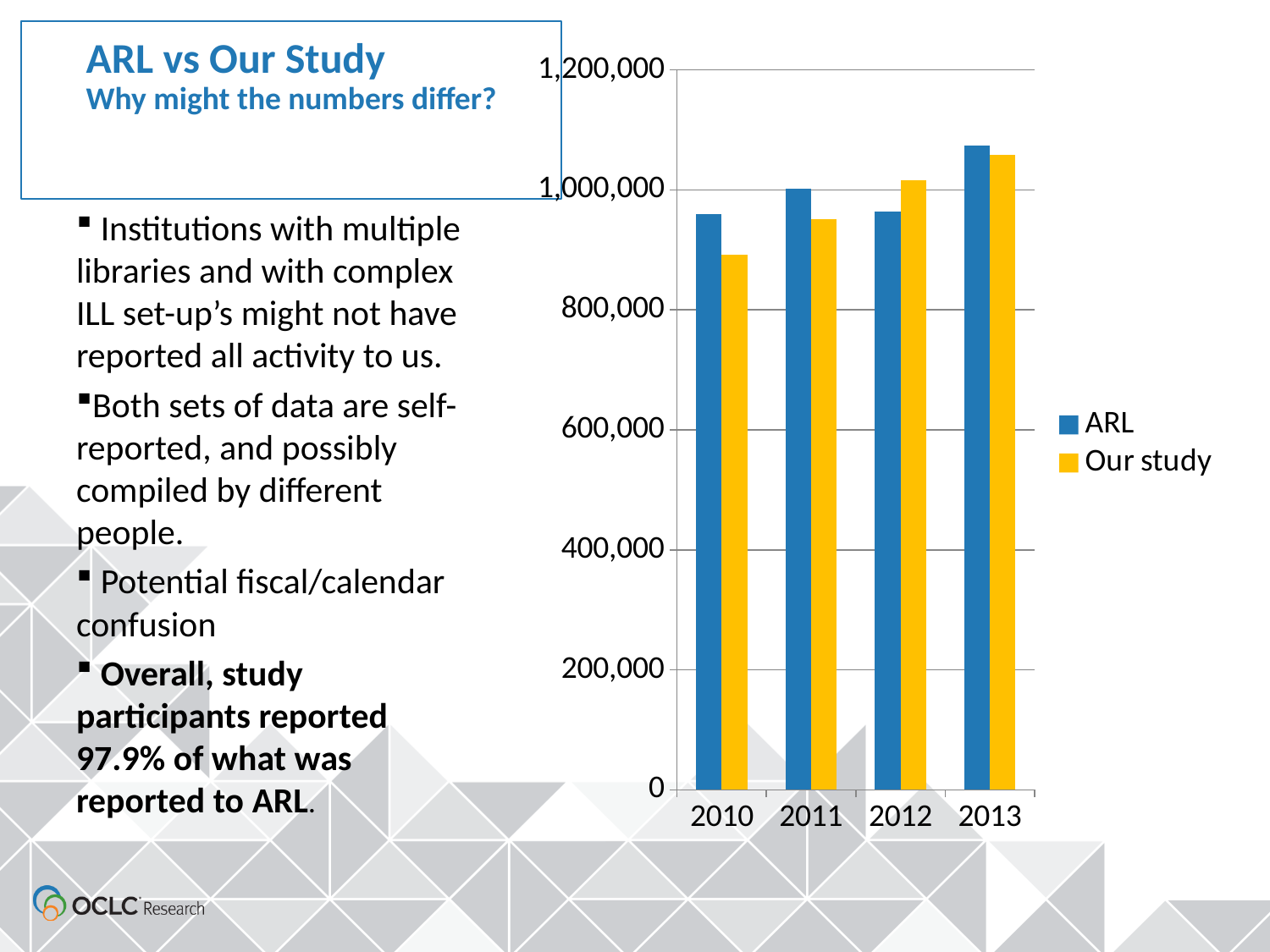
Which year has the lowest Our study value? 2010 Is the Our study value for 2010 greater or less than 1,000,000? less Which year has the highest ARL value? 2013 In 2012, which is larger, the ARL value or the Our study value? Our study Which two series are listed in the chart legend? ARL and Our study Do the Our study values rise or fall from 2010 to 2013? rise Is the ARL value for 2010 greater or less than 800,000? greater How many series does the chart legend list? 2 In 2010, which is larger, the ARL value or the Our study value? ARL Is the ARL value for 2013 greater or less than 1,000,000? greater How many years are shown on the x axis of the chart? 4 What kind of chart is shown on the slide? bar chart